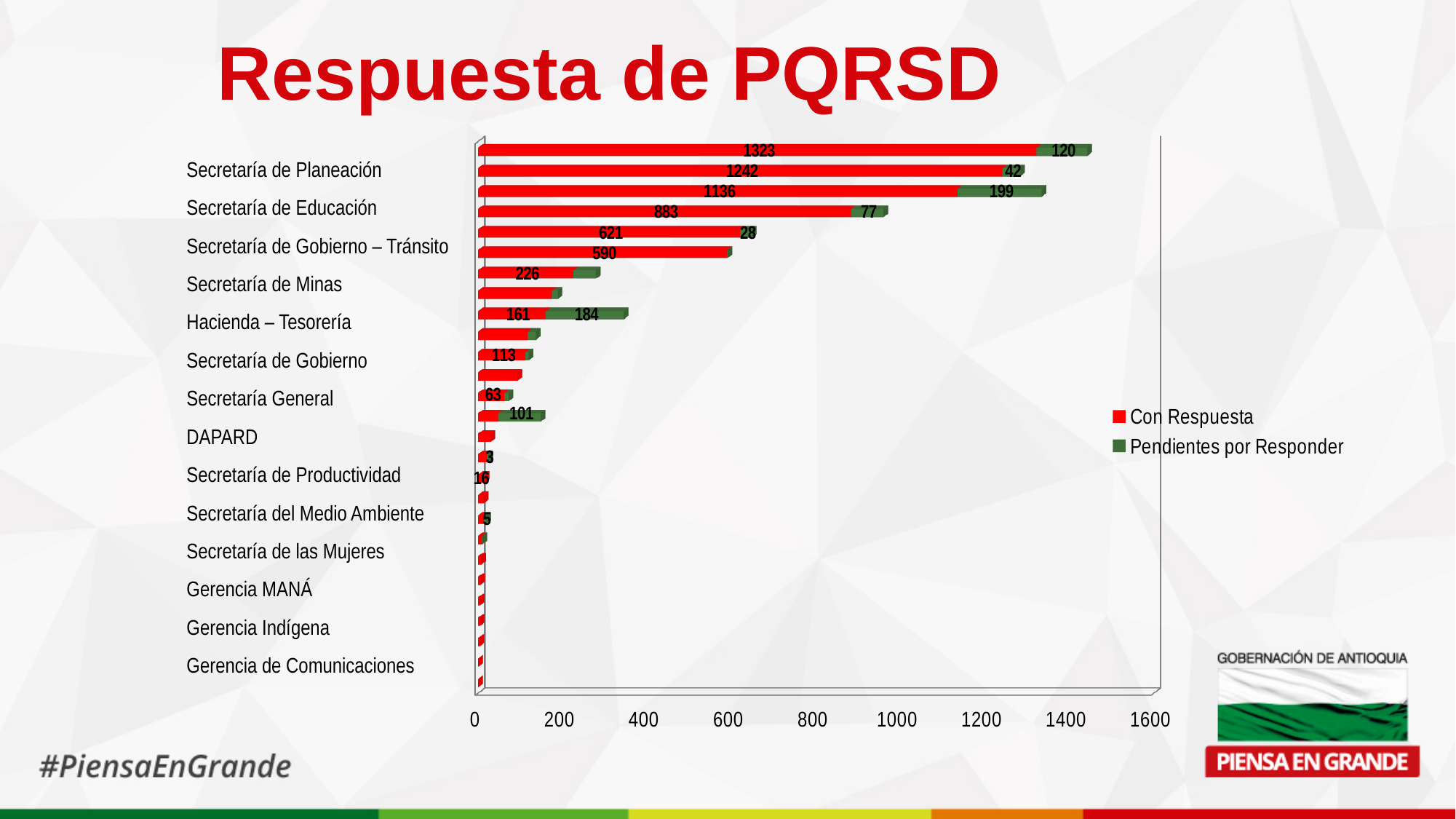
How many series does the legend list? 2 In the bar labeled 161 Con Respuesta and 184 Pendientes por Responder, which series has the larger value? Pendientes por Responder What is the largest Con Respuesta value labeled on the chart? 1323 What is the title of the slide containing the chart? Respuesta de PQRSD What is the total of the top bar, which has 1323 Con Respuesta and 120 Pendientes por Responder? 1443 What is the difference between the two largest Con Respuesta values, 1323 and 1242? 81 What is the total of the bar with 1136 Con Respuesta and 199 Pendientes por Responder? 1335 Is the total length of the longest bar greater or less than 1400? greater What kind of chart is shown on the slide? Bar chart What is the largest Pendientes por Responder value labeled on the chart? 199 What are the two series named in the legend? Con Respuesta and Pendientes por Responder How many category labels are printed along the vertical axis? 14